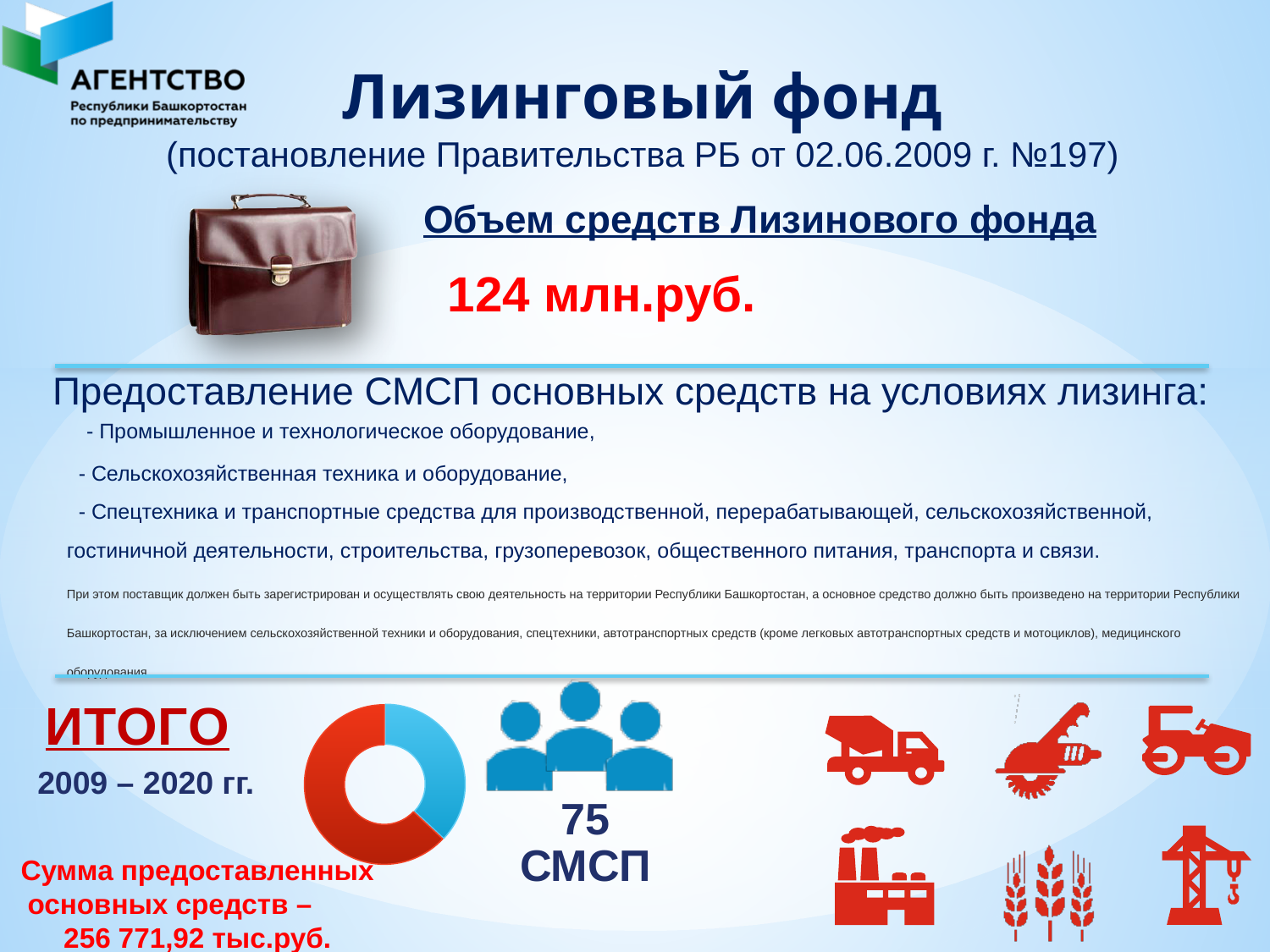
In the donut chart at the bottom left of the slide, which colour slice is the smallest? blue In the donut chart at the bottom left of the slide, which slice is larger, the red one or the blue one? red What two colours are used for the slices of the donut chart at the bottom left of the slide? red and blue How many slices does the donut chart at the bottom left of the slide have? 2 Does the donut chart at the bottom left of the slide show a legend? No What kind of chart is shown at the bottom left of the slide next to the word "ИТОГО"? pie chart (donut)